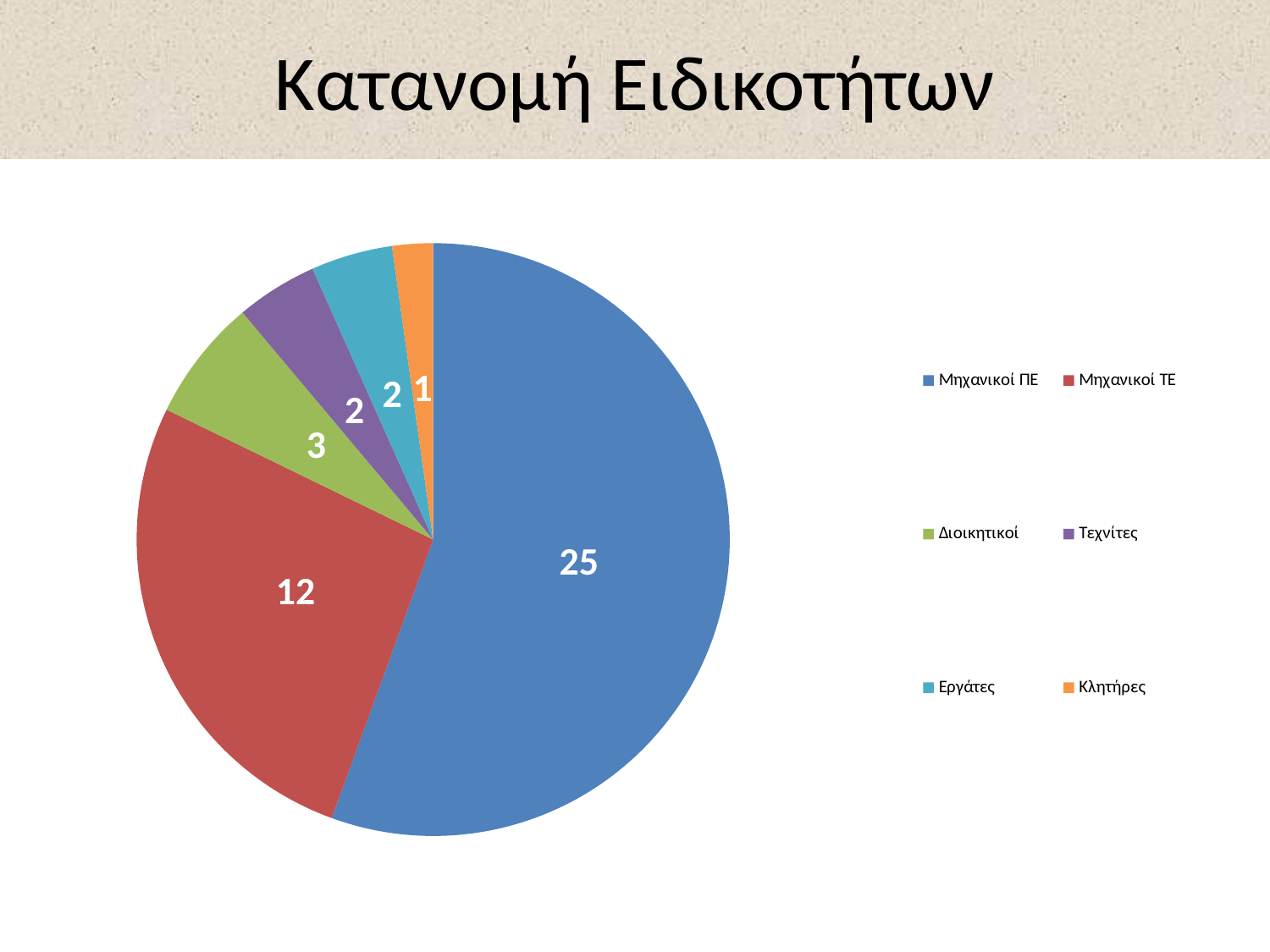
What is the value for Μηχανικοί ΤΕ in the pie chart? 12 Which category has the largest slice of the pie? Μηχανικοί ΠΕ Which category has the smallest slice of the pie? Κλητήρες What is the value for Κλητήρες in the pie chart? 1 What is the total of all the slices in the pie chart? 45 What is the value for Διοικητικοί in the pie chart? 3 How many categories does the pie chart have? 6 What is the difference between the values for Μηχανικοί ΠΕ and Μηχανικοί ΤΕ? 13 What is the title of the chart on the slide? Κατανομή Ειδικοτήτων What type of chart is shown on the slide? Pie chart What is the value for Μηχανικοί ΠΕ in the pie chart? 25 Which is larger, the value for Διοικητικοί or the value for Τεχνίτες? Διοικητικοί